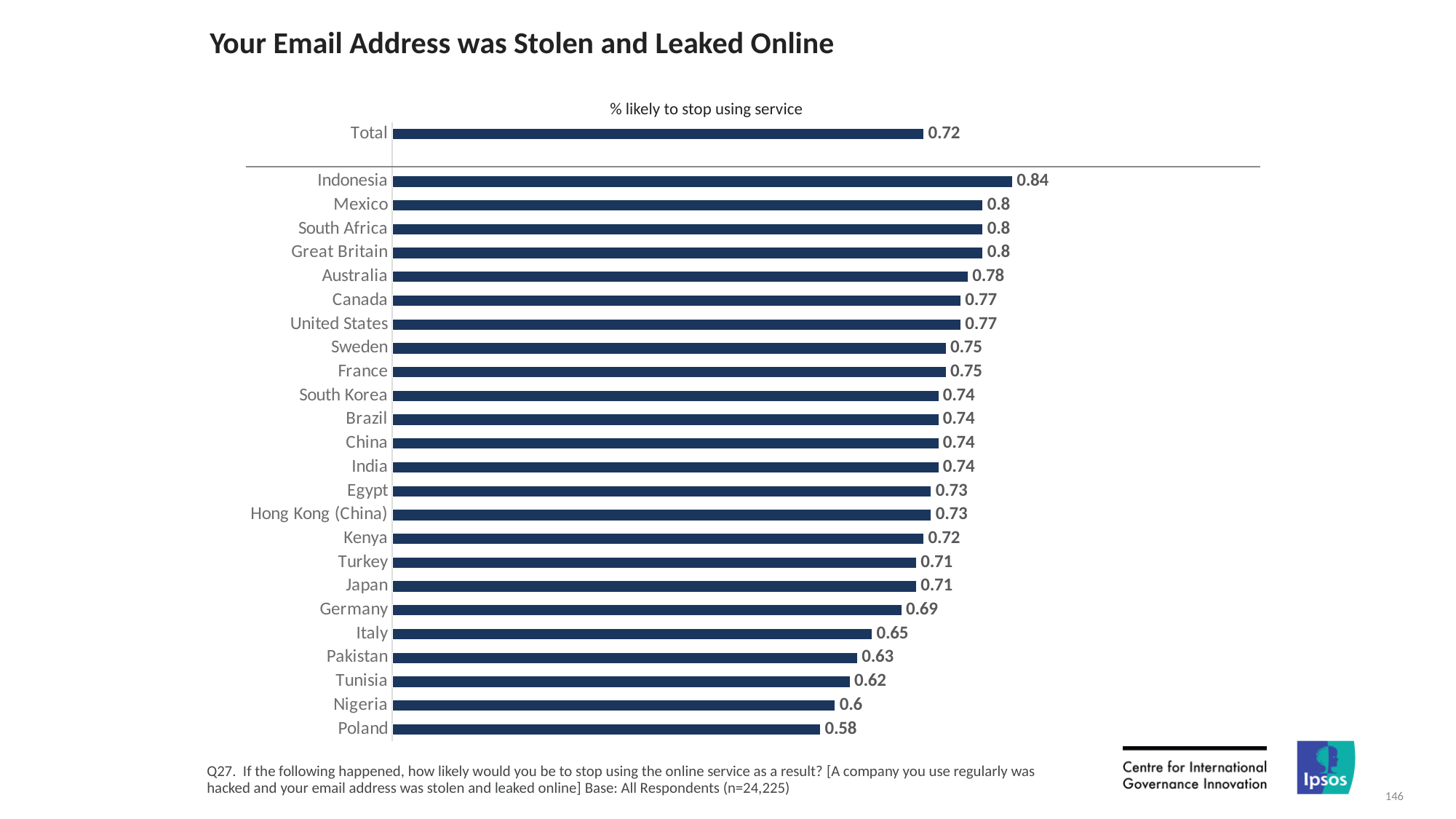
Which country has the lowest value? Poland What is the value for Total? 0.72 What is the difference between the values for Indonesia and Poland? 0.26 Which has a larger value, Canada or Nigeria? Canada What is the subtitle shown above the bars? % likely to stop using service What is the value for Hong Kong (China)? 0.73 How many countries are listed below the Total bar? 24 What is the value for Indonesia? 0.84 What is the value for Germany? 0.69 What kind of chart is shown? Bar chart Which country has the highest value? Indonesia What is the difference between the values for Australia and Italy? 0.13